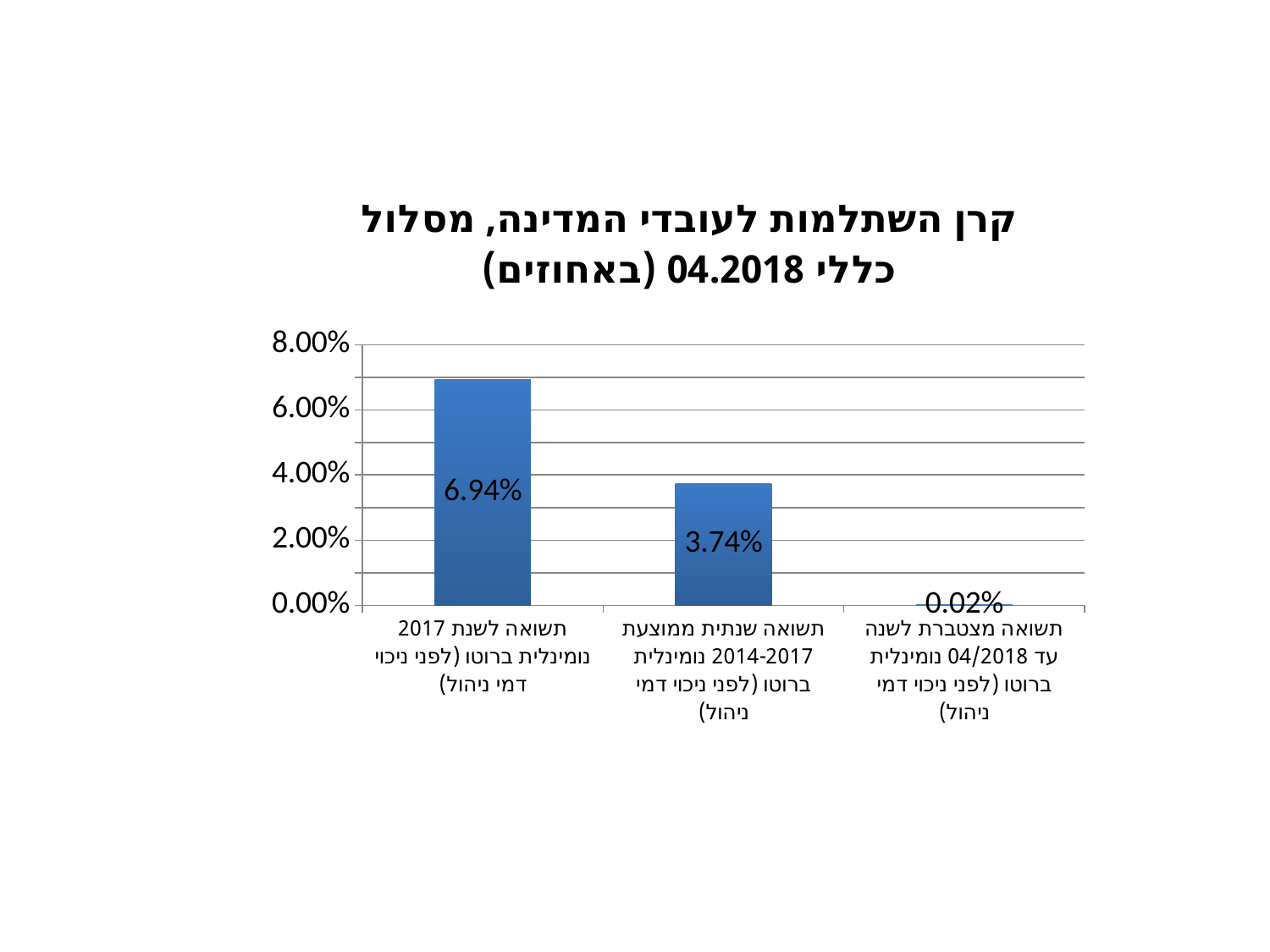
Is the value for "תשואה לשנת 2017 נומינלית ברוטו" greater or less than 6.00%? greater What is the value for the category "תשואה שנתית ממוצעת נומינלית 2014-2017 ברוטו (לפני ניכוי דמי ניהול)"? 3.74% What is the difference between the value for 2017 (6.94%) and the average annual value for 2014-2017 (3.74%)? 3.20% Is the value for "תשואה שנתית ממוצעת נומינלית 2014-2017" greater or less than 4.00%? less What kind of chart is shown on the slide? bar chart Which category has the lowest value? תשואה מצטברת לשנה עד 04/2018 נומינלית ברוטו (לפני ניכוי דמי ניהול) Which is larger: the value for "תשואה לשנת 2017" or the value for "תשואה שנתית ממוצעת 2014-2017"? תשואה לשנת 2017 Which category has the highest value? תשואה לשנת 2017 נומינלית ברוטו (לפני ניכוי דמי ניהול) What is the title of the chart? קרן השתלמות לעובדי המדינה, מסלול כללי 04.2018 (באחוזים) What is the value for the category "תשואה לשנת 2017 נומינלית ברוטו (לפני ניכוי דמי ניהול)"? 6.94% What is the value for the category "תשואה מצטברת לשנה עד 04/2018 נומינלית ברוטו (לפני ניכוי דמי ניהול)"? 0.02% How many categories are shown in the chart? 3